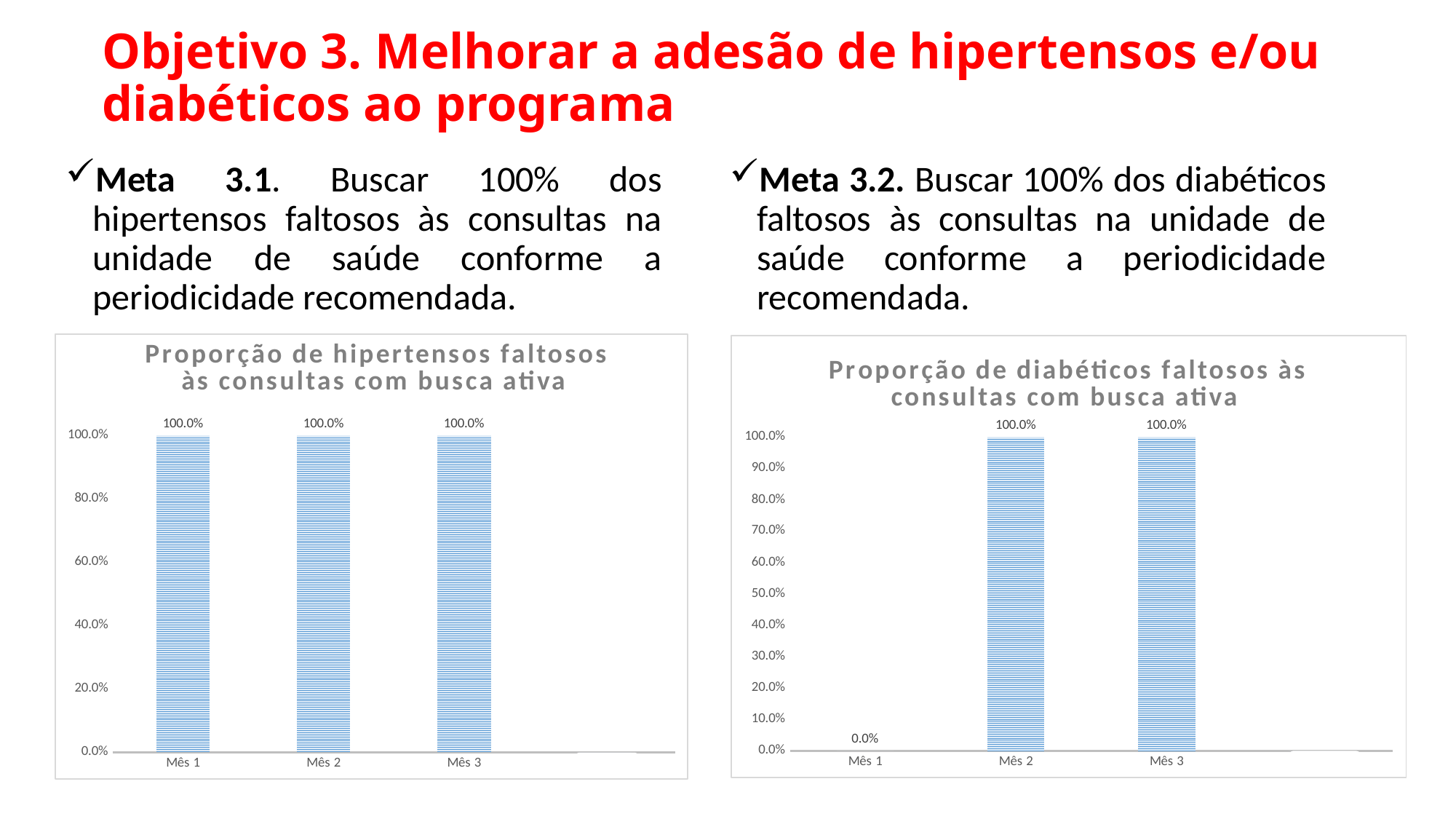
In the chart 'Proporção de diabéticos faltosos às consultas com busca ativa', which month has the lowest value? Mês 1 In the chart 'Proporção de diabéticos faltosos às consultas com busca ativa', do the values rise or fall from Mês 1 to Mês 2? Rise In the chart 'Proporção de diabéticos faltosos às consultas com busca ativa', what is the value for Mês 2? 100.0% In the chart 'Proporção de diabéticos faltosos às consultas com busca ativa', what is the value for Mês 1? 0.0% In the chart 'Proporção de diabéticos faltosos às consultas com busca ativa', which is larger, the value for Mês 1 or Mês 3? Mês 3 In the chart 'Proporção de diabéticos faltosos às consultas com busca ativa', what is the difference between the values for Mês 2 and Mês 1? 100.0% How many categories are shown on the x axis of the chart 'Proporção de diabéticos faltosos às consultas com busca ativa'? 3 What kind of chart is the chart on the left of the slide? Bar chart In the chart 'Proporção de hipertensos faltosos às consultas com busca ativa', what is the value for Mês 3? 100.0% How many categories are shown on the x axis of the chart 'Proporção de hipertensos faltosos às consultas com busca ativa'? 3 In the chart 'Proporção de hipertensos faltosos às consultas com busca ativa', what is the value for Mês 1? 100.0% What is the title of the chart on the right of the slide? Proporção de diabéticos faltosos às consultas com busca ativa